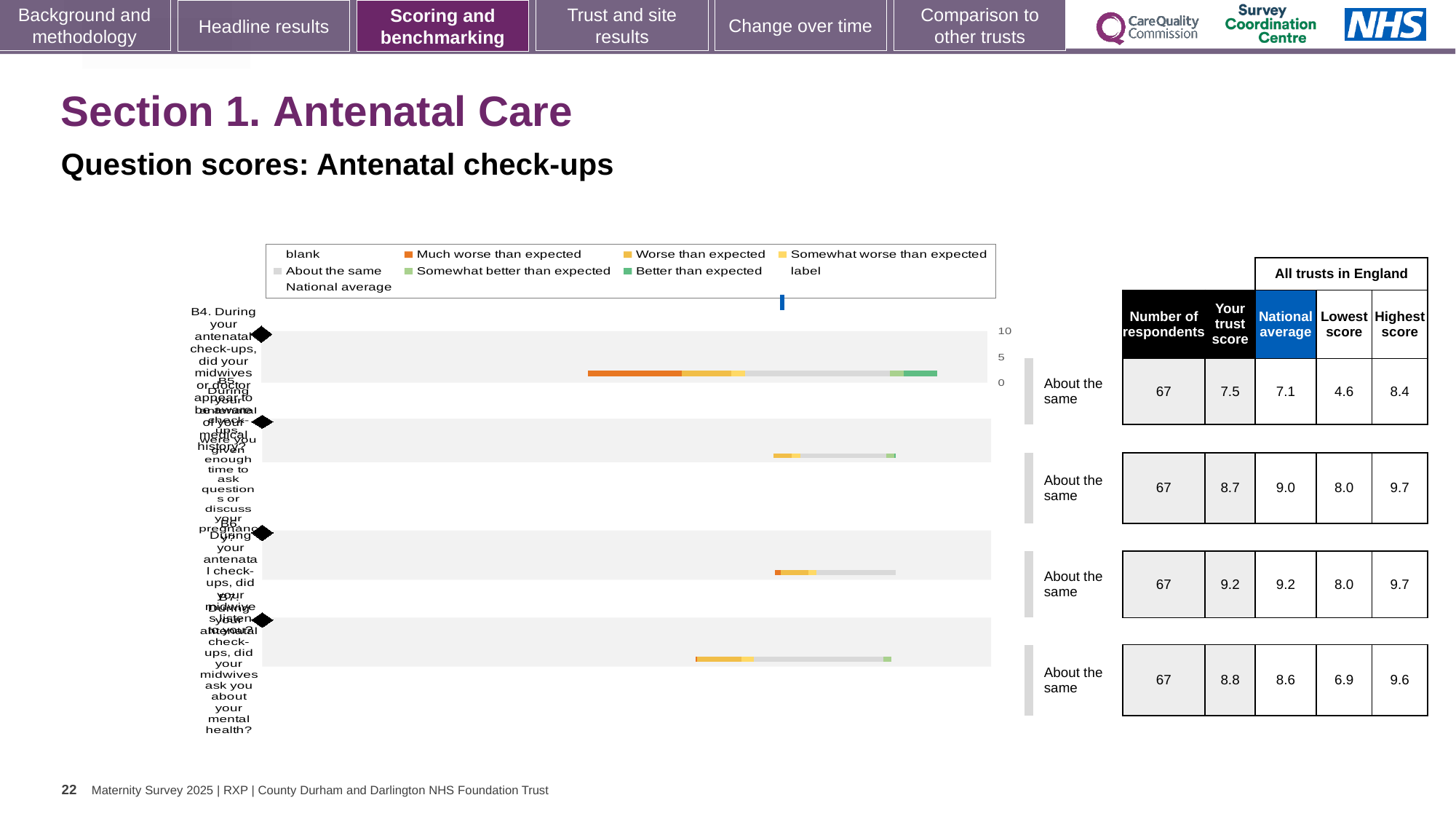
Which question has the highest trust score in the table? B6 (9.2) According to the table next to the chart, what is the national average for question B4? 7.1 What kind of chart is shown on the slide? bar chart For question B5, is the trust score (8.7) higher or lower than the national average (9.0)? lower How many respondents are listed for each question in the table? 67 What benchmark category is shown for all four questions? About the same What is the difference between the highest score (8.4) and the lowest score (4.6) for question B4? 3.8 How many questions (bars) are plotted in the chart? 4 What colour does the legend use for 'Much worse than expected'? orange Which question has the lowest trust score in the table? B4 (7.5) According to the table next to the chart, what is the trust score for question B4 (midwives or doctor aware of your medical history)? 7.5 What is the highest score across all trusts in England for question B4? 8.4